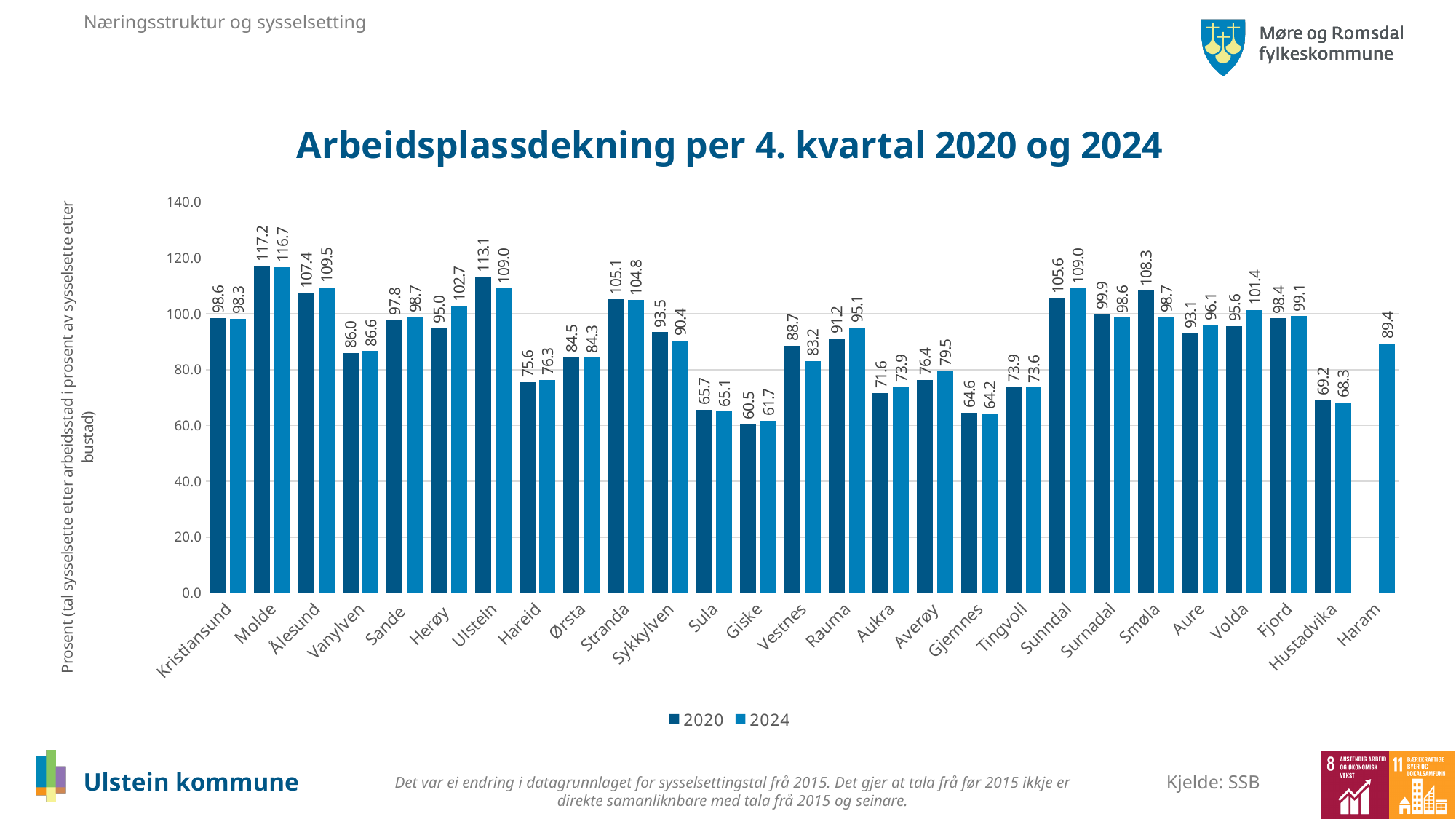
How many series does the legend list? 2 Which is larger: the 2020 value for Ulstein or the 2020 value for Sunndal? Ulstein Which municipality has the highest value in 2020? Molde What kind of chart is shown on the slide? bar chart Is the 2024 value for Volda greater or less than 100.0? greater How many municipalities are shown on the x axis? 27 What is the difference between the 2020 and 2024 values for Smøla? 9.6 What is the difference between the 2024 and 2020 values for Herøy? 7.7 What is the value for Herøy in 2024? 102.7 What is the value for Ulstein in 2020? 113.1 What is the 2024 value for Haram? 89.4 Which municipality has the lowest value in 2024? Giske